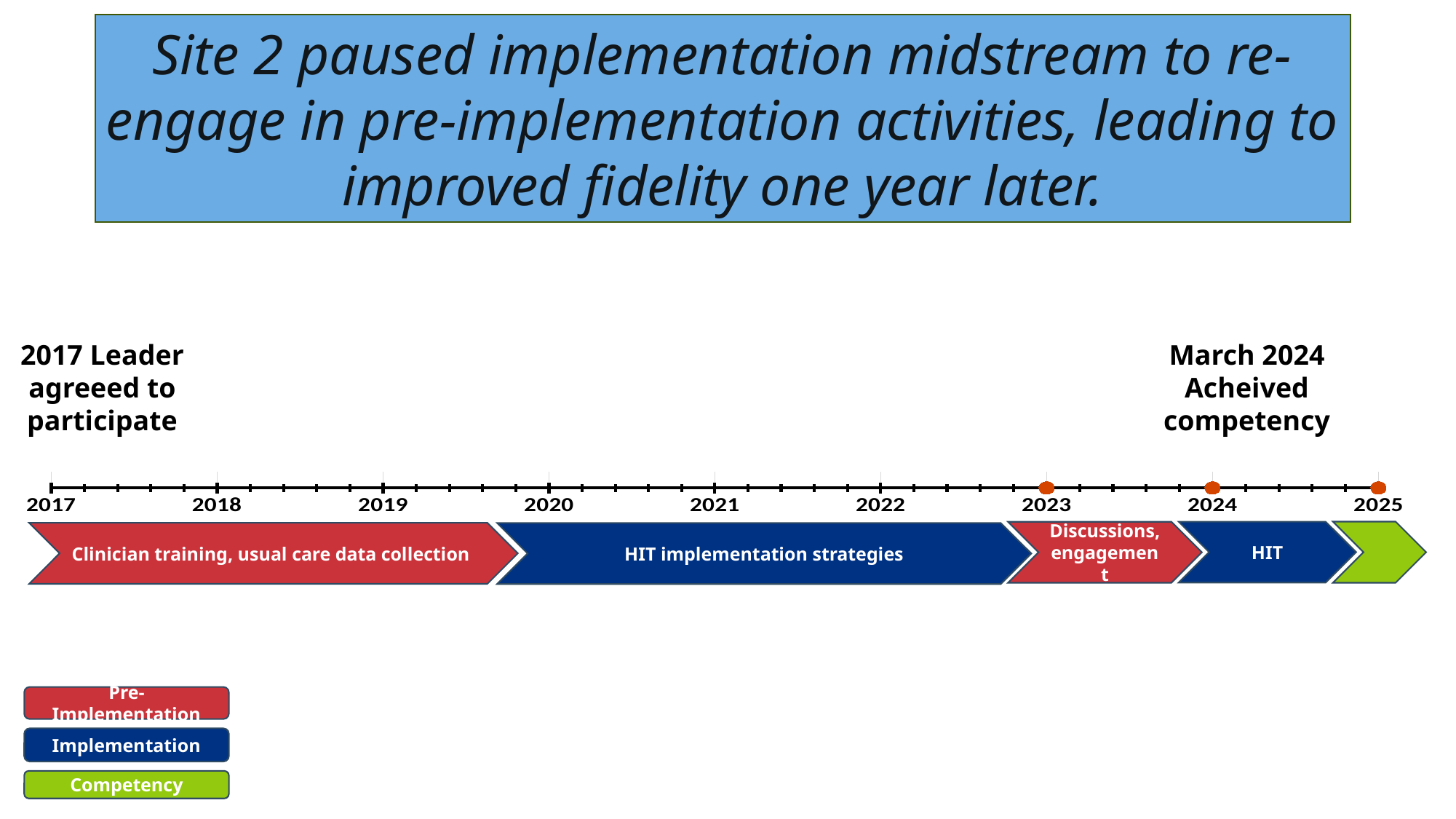
What is the last year labeled on the timeline axis? 2025 What event is annotated at 2017 on the timeline? Leader agreed to participate Which phase label appears on the arrow spanning roughly 2020 to 2023? HIT implementation strategies How many years are labeled along the timeline axis? 9 How many categories does the legend list? 3 What kind of chart is shown on the slide? Timeline Which legend category is shown in green? Competency What event is annotated at March 2024 on the timeline? Achieved competency What is the label of the first (leftmost) phase arrow on the timeline? Clinician training, usual care data collection How many phase arrows are shown along the timeline? 5 What is the first year labeled on the timeline axis? 2017 Which legend category is shown in dark blue? Implementation